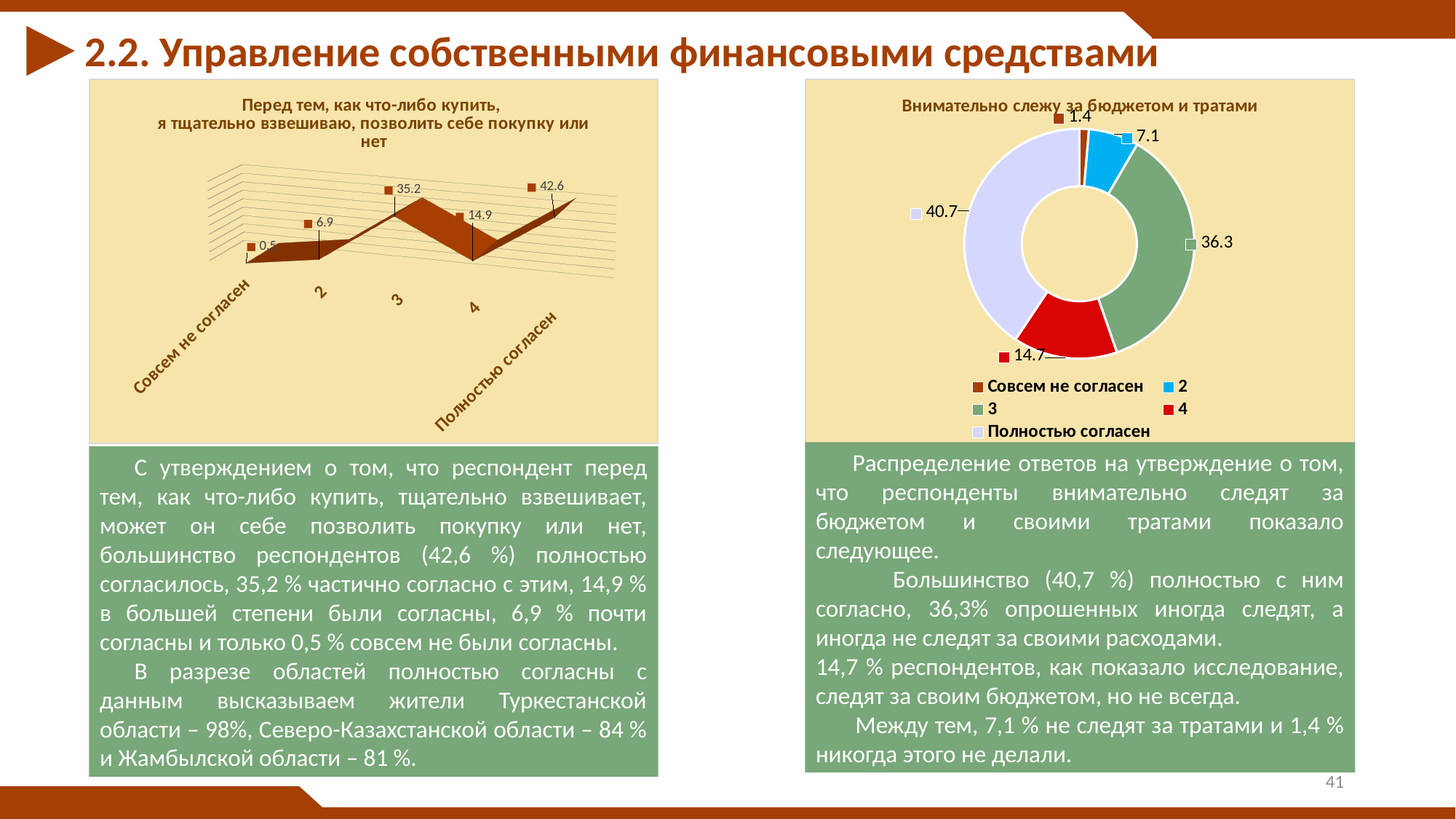
In the left chart ("Перед тем, как что-либо купить..."), what is the value for "Полностью согласен"? 42.6 In the left chart ("Перед тем, как что-либо купить..."), which is larger: the value for category 2 or the value for category 4? category 4 In the right chart ("Внимательно слежу за бюджетом и тратами"), what is the value for category 4? 14.7 In the right chart ("Внимательно слежу за бюджетом и тратами"), what is the difference between the values for "Полностью согласен" and category 3? 4.4 In the right chart ("Внимательно слежу за бюджетом и тратами"), what is the value for "Полностью согласен"? 40.7 In the left chart ("Перед тем, как что-либо купить..."), what is the difference between the values for category 3 and category 4? 20.3 In the right chart ("Внимательно слежу за бюджетом и тратами"), which category has the smallest slice? Совсем не согласен In the right chart ("Внимательно слежу за бюджетом и тратами"), how many entries does the legend list? 5 What kind of chart is the right chart ("Внимательно слежу за бюджетом и тратами")? doughnut chart In the left chart ("Перед тем, как что-либо купить..."), which category has the lowest value? Совсем не согласен In the left chart ("Перед тем, как что-либо купить..."), what is the value for category 3? 35.2 In the left chart ("Перед тем, как что-либо купить..."), how many categories are plotted? 5